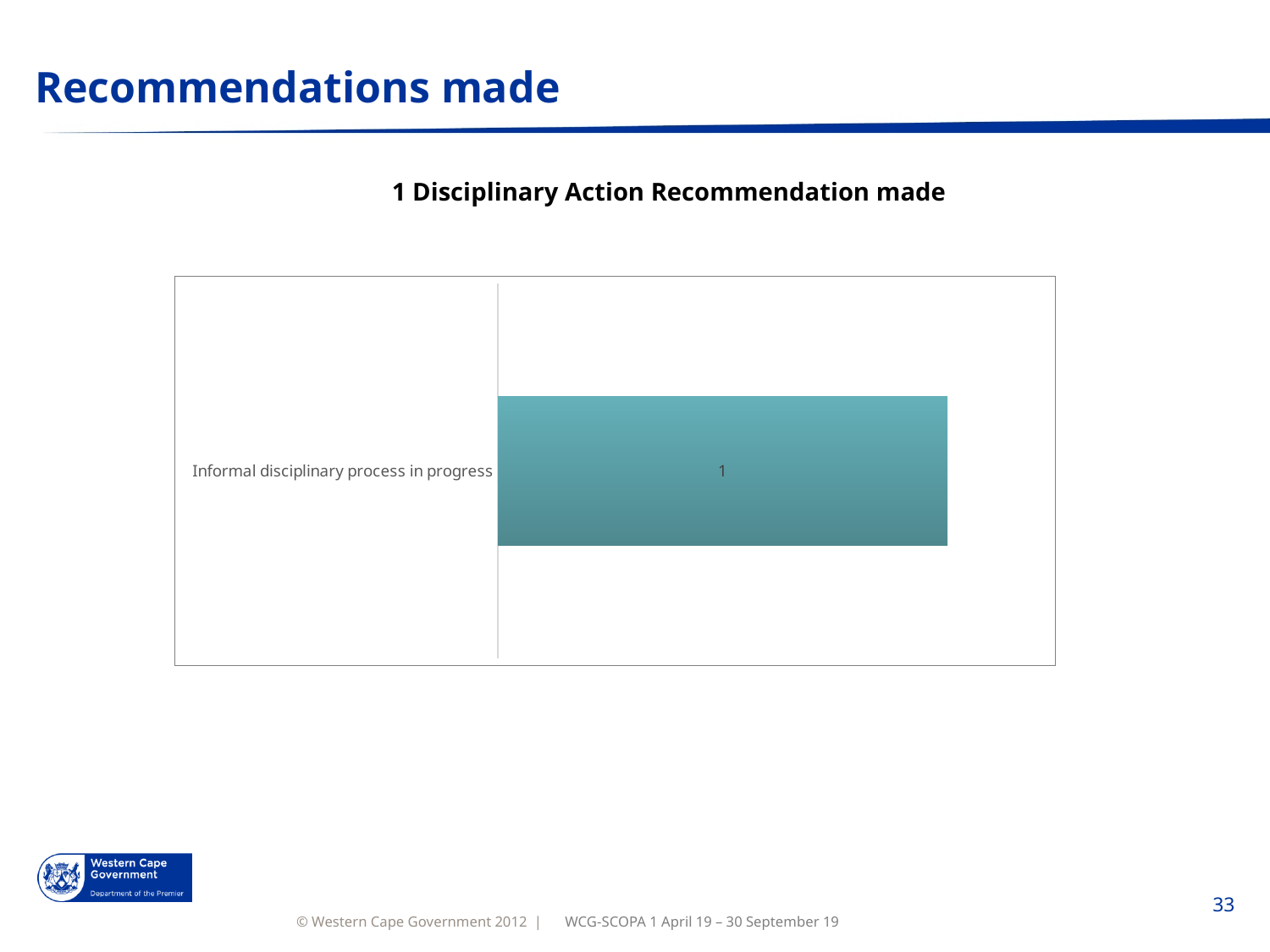
What is the label of the only category in the chart? Informal disciplinary process in progress Are the bars in the chart horizontal or vertical? horizontal What is the title shown above the chart? 1 Disciplinary Action Recommendation made What is the value for "Informal disciplinary process in progress"? 1 What kind of chart is shown on the slide? bar chart How many categories does the chart show? 1